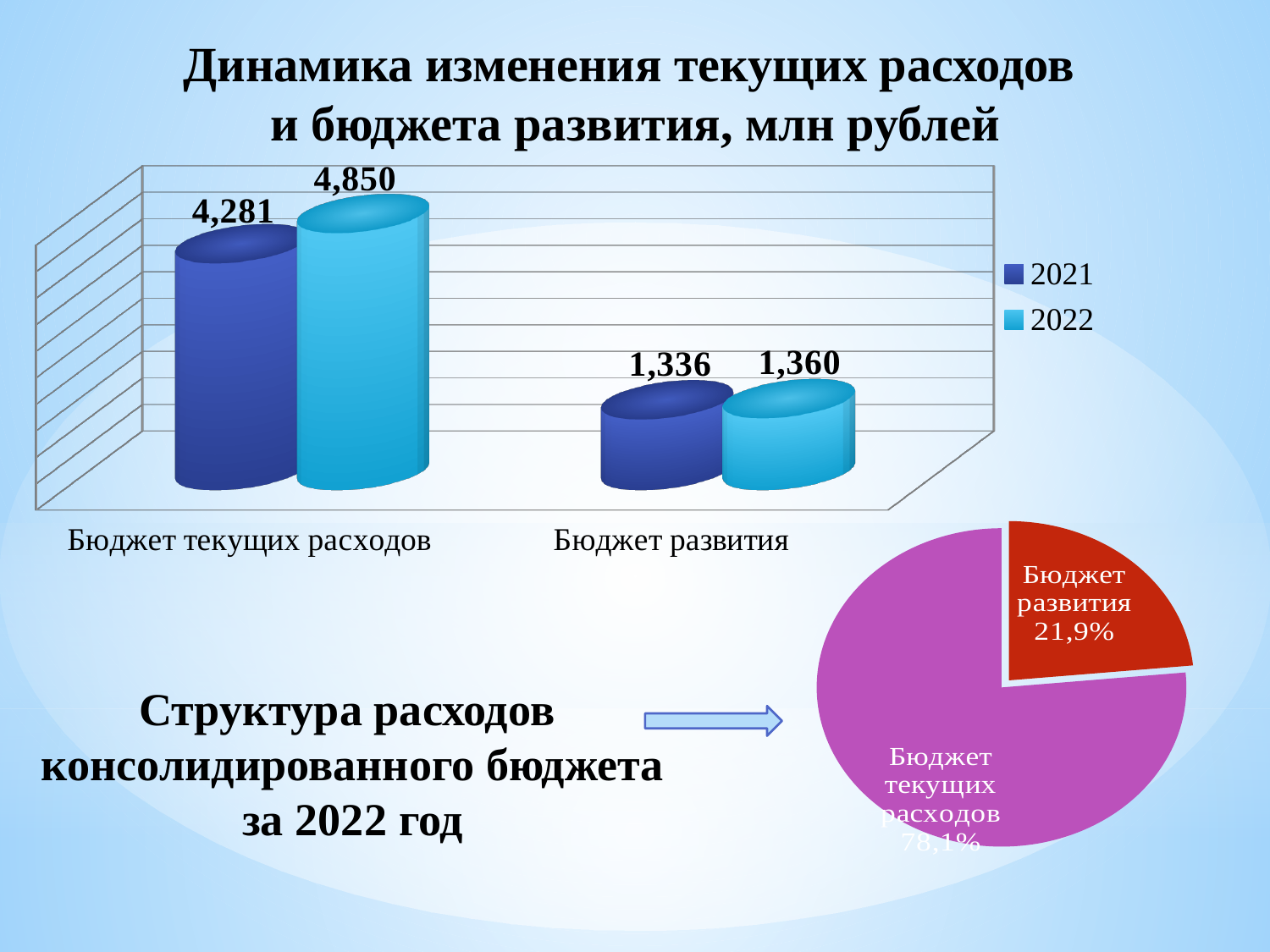
In the bar chart 'Динамика изменения текущих расходов и бюджета развития, млн рублей', what is the difference between the 2022 and 2021 values for Бюджет развития? 24 In the bar chart 'Динамика изменения текущих расходов и бюджета развития, млн рублей', by how much did Бюджет текущих расходов increase from 2021 to 2022? 569 In the pie chart 'Структура расходов консолидированного бюджета за 2022 год', what share does Бюджет развития have? 21,9% In the bar chart 'Динамика изменения текущих расходов и бюджета развития, млн рублей', what is the value for Бюджет развития in 2022? 1,360 How many categories are shown in the bar chart 'Динамика изменения текущих расходов и бюджета развития, млн рублей'? 2 In the bar chart 'Динамика изменения текущих расходов и бюджета развития, млн рублей', what is the value for Бюджет текущих расходов in 2022? 4,850 In the bar chart 'Динамика изменения текущих расходов и бюджета развития, млн рублей', what is the value for Бюджет развития in 2021? 1,336 How many series does the legend of the bar chart 'Динамика изменения текущих расходов и бюджета развития, млн рублей' list? 2 In the bar chart 'Динамика изменения текущих расходов и бюджета развития, млн рублей', what is the value for Бюджет текущих расходов in 2021? 4,281 In the bar chart 'Динамика изменения текущих расходов и бюджета развития, млн рублей', which is larger: Бюджет развития in 2021 or Бюджет развития in 2022? 2022 In the bar chart 'Динамика изменения текущих расходов и бюджета развития, млн рублей', which category has the highest value in 2022? Бюджет текущих расходов In the pie chart 'Структура расходов консолидированного бюджета за 2022 год', what share does Бюджет текущих расходов have? 78,1%